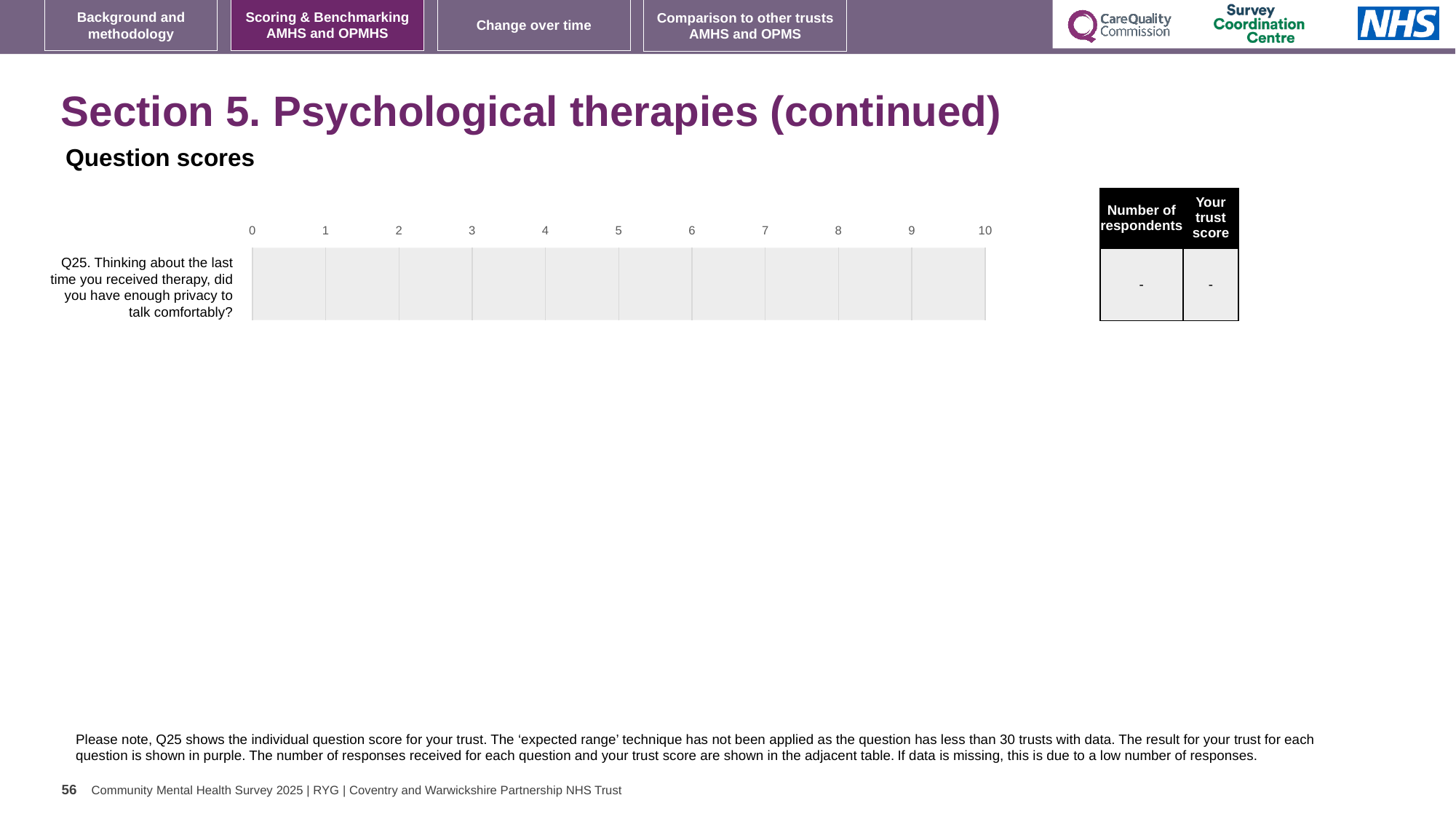
What is shown in the 'Your trust score' column of the table for Q25? - Is a bar plotted for Q25 on the chart? No What is the lowest value shown on the chart's x axis? 0 What is shown in the 'Number of respondents' column of the table for Q25? - What is the highest value shown on the chart's x axis? 10 How many questions (categories) are listed on the chart? 1 Which question number is shown on the chart? Q25